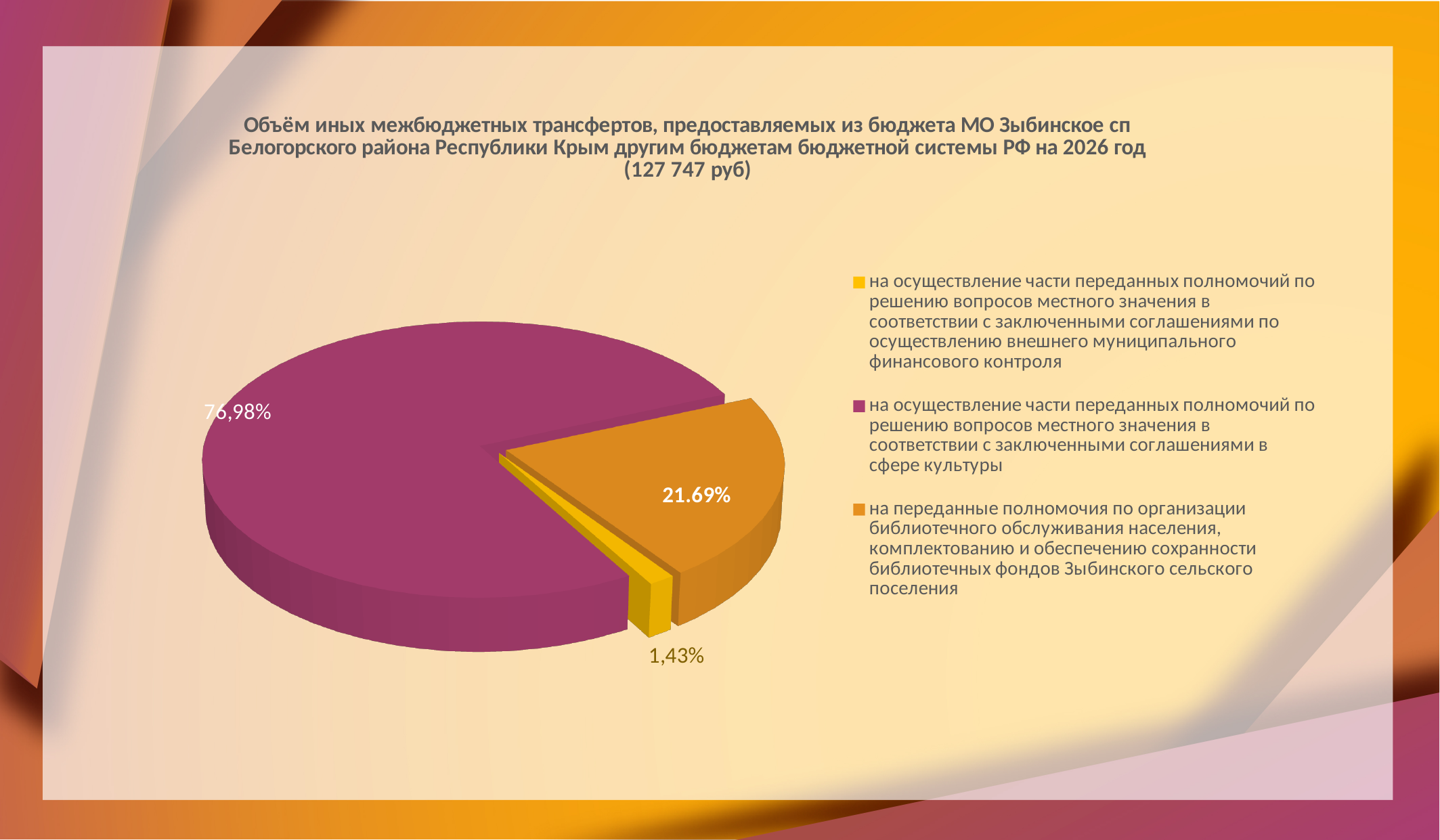
Which slice of the pie is the smallest? на осуществление части переданных полномочий по решению вопросов местного значения в соответствии с заключенными соглашениями по осуществлению внешнего муниципального финансового контроля What share of the pie is the slice for library services (библиотечного обслуживания населения)? 21.69% How many slices does the pie chart have? 3 How many entries does the legend list? 3 Which is larger: the slice for library services or the slice for external municipal financial control? library services (21.69%) What kind of chart is shown on the slide? pie chart What share of the pie is the slice for transfers in the sphere of culture (в сфере культуры)? 76,98% What total amount in rubles is stated in the chart title? 127 747 руб What colour is the slice representing transfers in the sphere of culture? magenta (purple-pink) What is the difference in percentage points between the culture slice (76,98%) and the external municipal financial control slice (1,43%)? 75,55% Which slice of the pie is the largest? на осуществление части переданных полномочий по решению вопросов местного значения в соответствии с заключенными соглашениями в сфере культуры What share of the pie is the slice for external municipal financial control (внешнего муниципального финансового контроля)? 1,43%